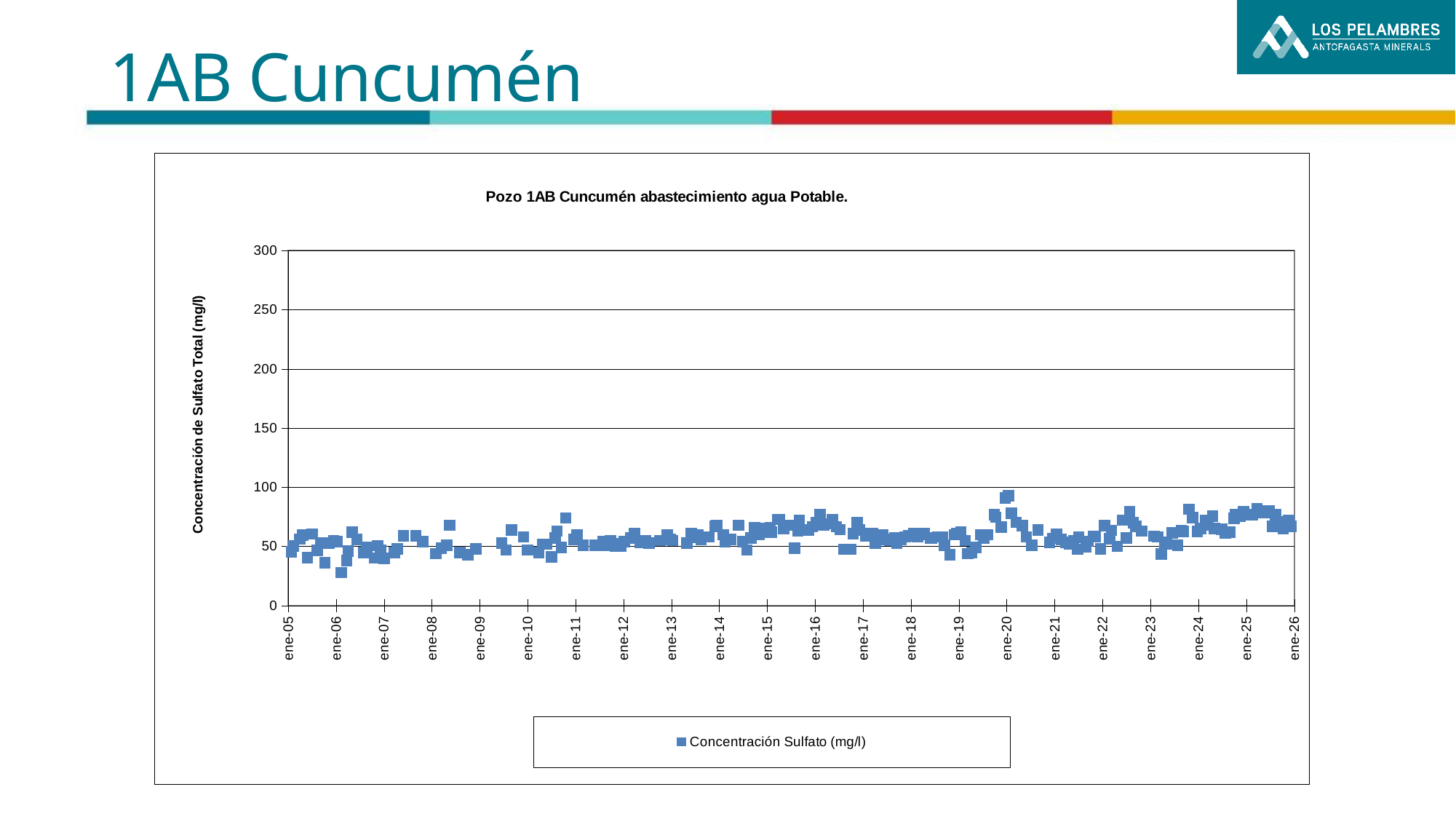
Is the lowest plotted value greater or less than 50? less How many series does the legend list? 1 What is the last label on the x axis? ene-26 What is the maximum value shown on the y axis? 300 What is the series name shown in the legend? Concentración Sulfato (mg/l) What kind of chart is shown on the slide? scatter chart Is the highest plotted value greater or less than 100? less Is the highest plotted value greater or less than 150? less